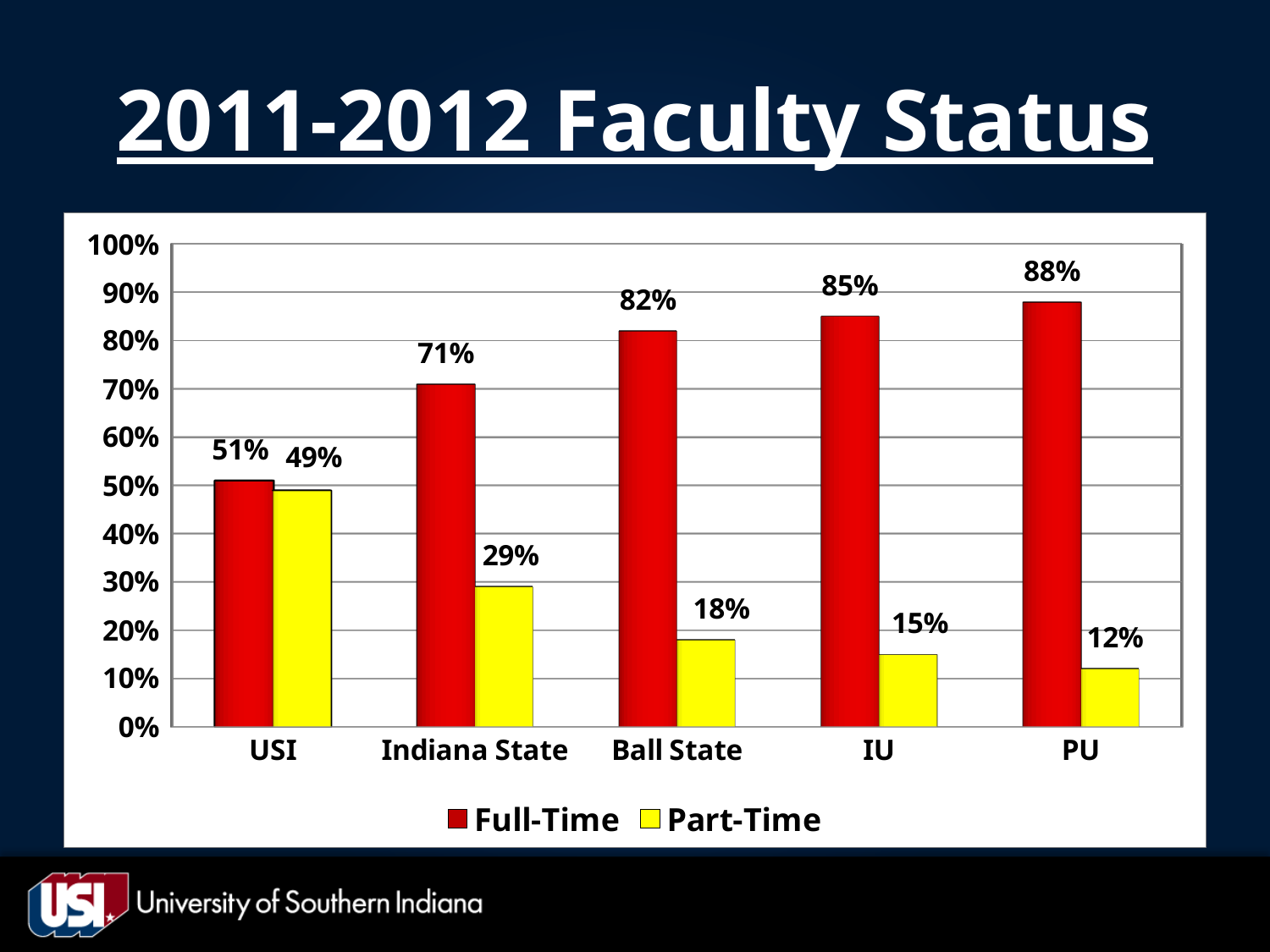
Which institution has the highest Full-Time value? PU What is the Part-Time value for Indiana State? 29% How many institutions are shown on the x axis? 5 What is the Part-Time value for PU? 12% Do the Part-Time values rise or fall from USI to PU along the x axis? Fall What is the Full-Time value for USI? 51% What is the difference between the Full-Time and Part-Time values for IU? 70% Which institution has the lowest Part-Time value? PU What kind of chart is shown on the slide? Bar chart How many series does the legend list? 2 What is the Full-Time value for Ball State? 82% Which is larger, the Part-Time value for USI or the Part-Time value for Ball State? USI